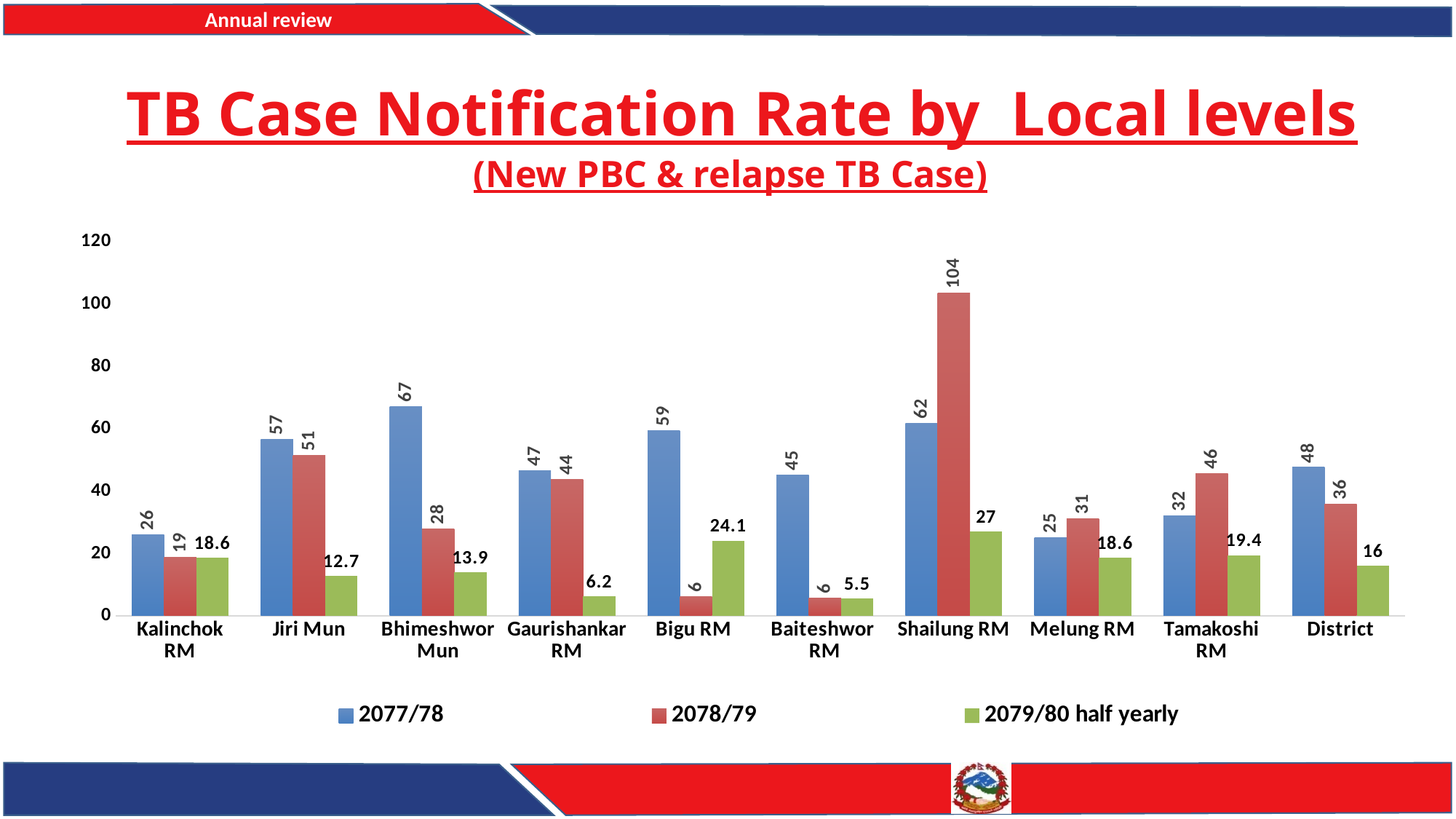
Which local level has the lowest 2079/80 half yearly value? Baiteshwor RM What is the 2077/78 value for Bhimeshwor Mun? 67 How many series does the legend list? 3 What is the 2078/79 value for Shailung RM? 104 Which local level has the highest 2078/79 value? Shailung RM What is the difference between the 2077/78 and 2078/79 values for Bigu RM? 53 How many local levels (categories) are shown on the x axis? 10 What is the subtitle shown under the chart title? (New PBC & relapse TB Case) What is the 2079/80 half yearly value for Bigu RM? 24.1 What is the 2079/80 half yearly value for District? 16 What kind of chart is shown on the slide? Bar chart Which is larger for Tamakoshi RM: the 2077/78 value or the 2078/79 value? 2078/79